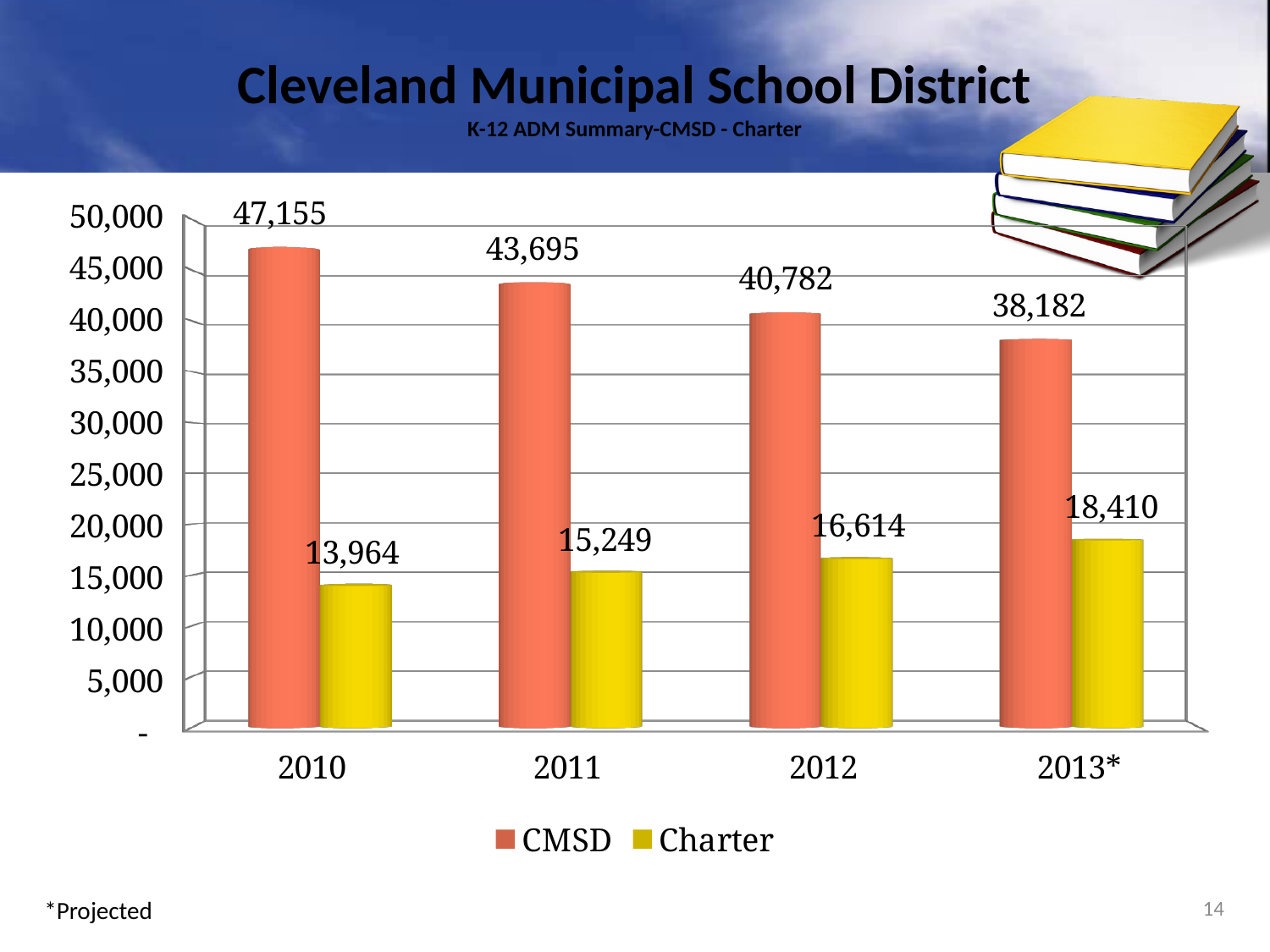
Which year has the lowest CMSD value? 2013* Is the Charter value for 2010 greater or less than 15,000? less What is the Charter value for 2013*? 18,410 What is the difference between the CMSD and Charter values in 2011? 28,446 Which is larger in 2012, the CMSD value or the Charter value? CMSD What is the CMSD value for 2010? 47,155 What kind of chart is shown on the slide? bar chart Do the CMSD values rise or fall from 2010 to 2013*? fall What is the CMSD value for 2012? 40,782 Which year has the highest Charter value? 2013* How many years are shown on the x axis? 4 How many series does the legend list? 2